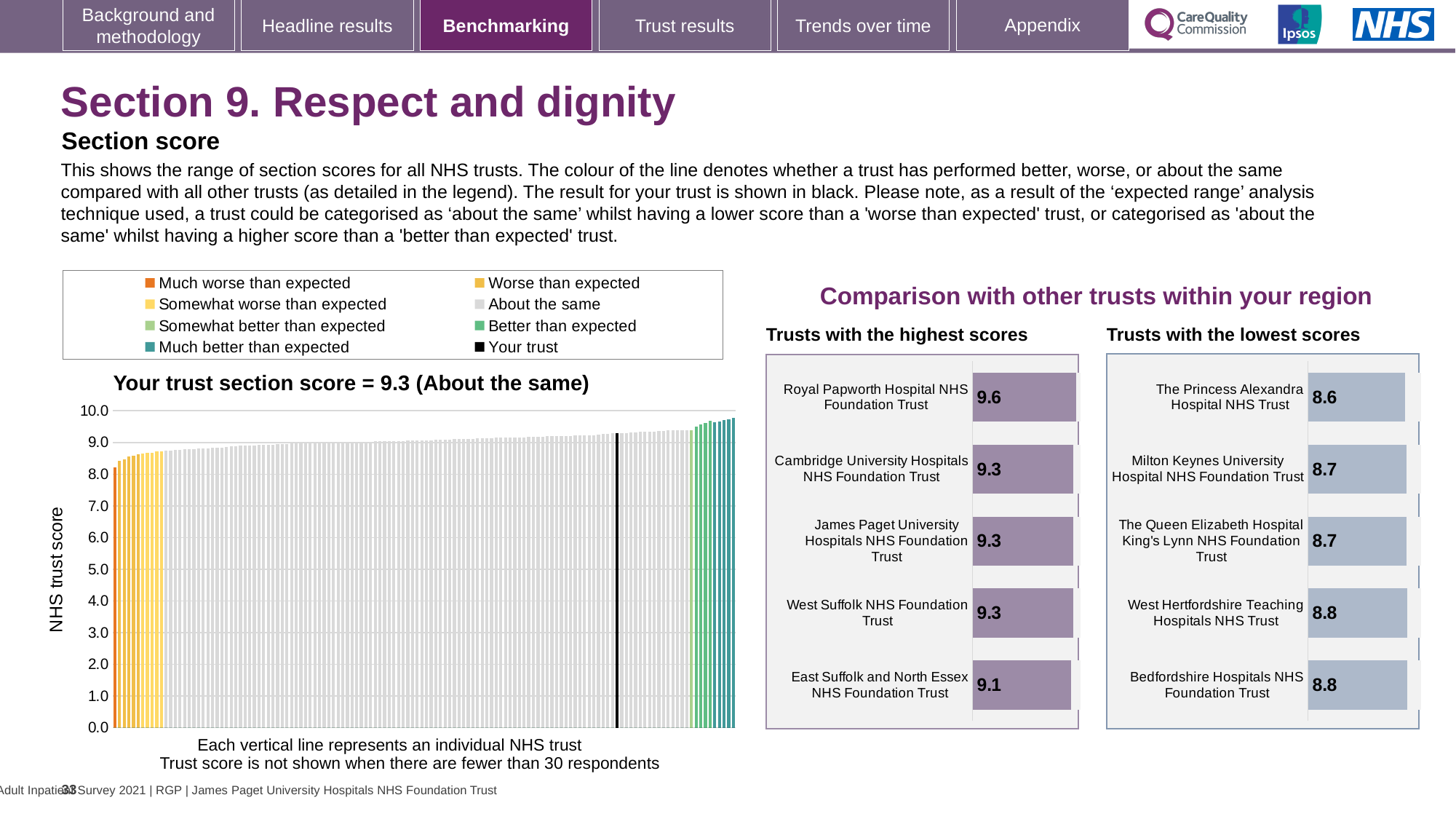
In the 'Your trust section score' chart, what is the section score for your trust? 9.3 What kind of chart is the 'Your trust section score' chart? Bar chart In the 'Trusts with the highest scores' chart, which trust has the lowest score? East Suffolk and North Essex NHS Foundation Trust In the 'Trusts with the lowest scores' chart, what is the score for Milton Keynes University Hospital NHS Foundation Trust? 8.7 In the 'Trusts with the lowest scores' chart, which is larger: the score for West Hertfordshire Teaching Hospitals NHS Trust or The Princess Alexandra Hospital NHS Trust? West Hertfordshire Teaching Hospitals NHS Trust In the 'Trusts with the highest scores' chart, what is the difference between the scores of Royal Papworth Hospital NHS Foundation Trust and East Suffolk and North Essex NHS Foundation Trust? 0.5 In the 'Trusts with the lowest scores' chart, which trust has the lowest score? The Princess Alexandra Hospital NHS Trust How many entries does the legend above the 'Your trust section score' chart list? 8 In the 'Trusts with the highest scores' chart, what is the score for Royal Papworth Hospital NHS Foundation Trust? 9.6 In the 'Trusts with the lowest scores' chart, what is the difference between the scores of Bedfordshire Hospitals NHS Foundation Trust and The Princess Alexandra Hospital NHS Trust? 0.2 In the 'Your trust section score' chart, do the trust scores rise or fall from left to right along the x axis? Rise In the 'Trusts with the highest scores' chart, how many trusts are listed? 5